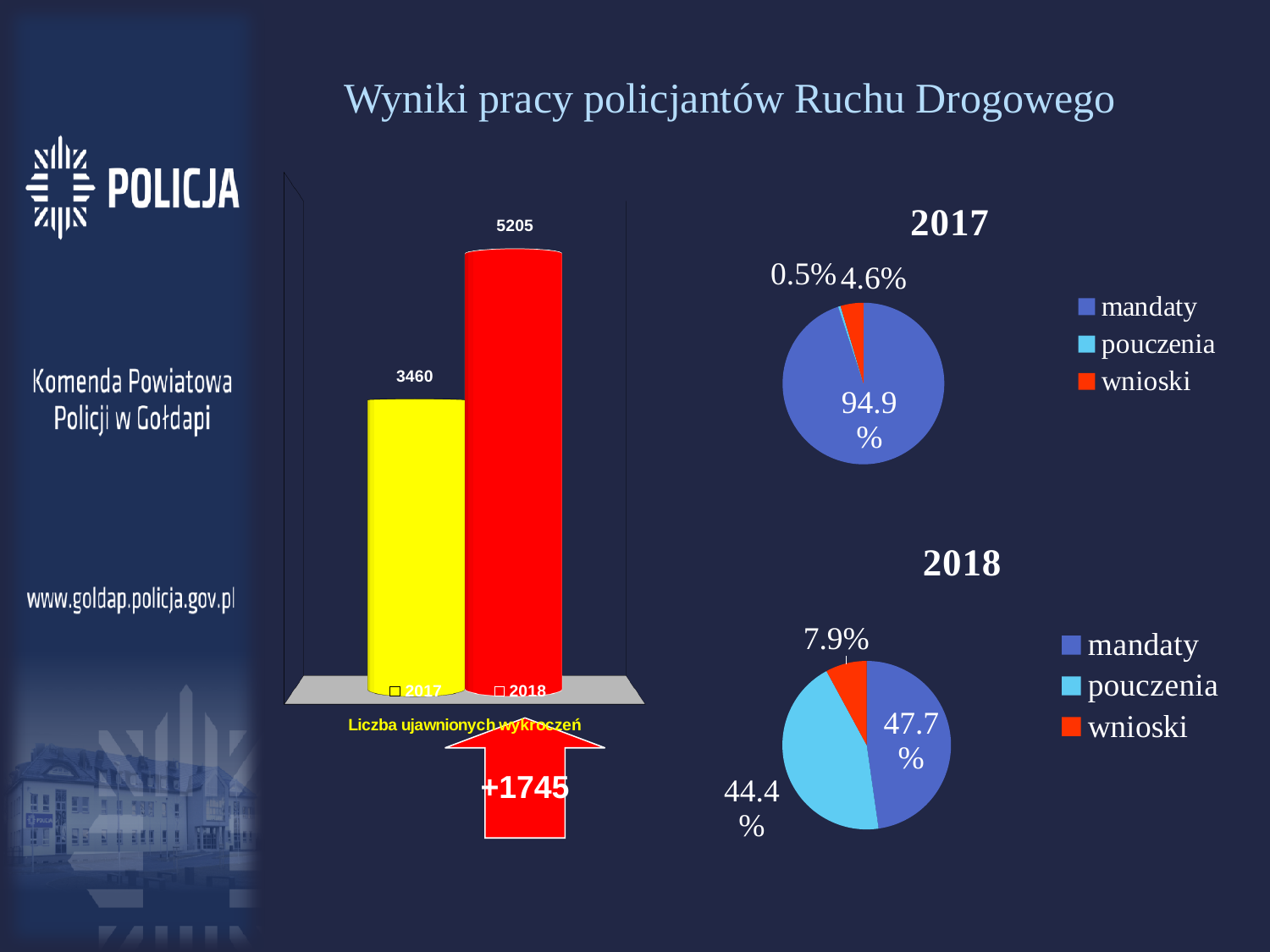
In the bar chart 'Liczba ujawnionych wykroczeń', how many bars are shown? 2 In the bar chart 'Liczba ujawnionych wykroczeń', what is the value for 2018? 5205 In the bar chart 'Liczba ujawnionych wykroczeń', what is the value for 2017? 3460 In the 2017 pie chart, what share does 'mandaty' have? 94.9% In the 2018 pie chart, what share does 'pouczenia' have? 44.4% In the 2017 pie chart, which category has the smallest share? pouczenia In the bar chart 'Liczba ujawnionych wykroczeń', which year has the higher value? 2018 In the bar chart 'Liczba ujawnionych wykroczeń', what is the difference between the 2018 and 2017 values? 1745 In the 2018 pie chart, which category has the largest share? mandaty In the 2017 pie chart, what share does 'wnioski' have? 4.6% What kind of chart is the chart titled 'Liczba ujawnionych wykroczeń'? bar chart How many entries does the legend of the 2018 pie chart list? 3